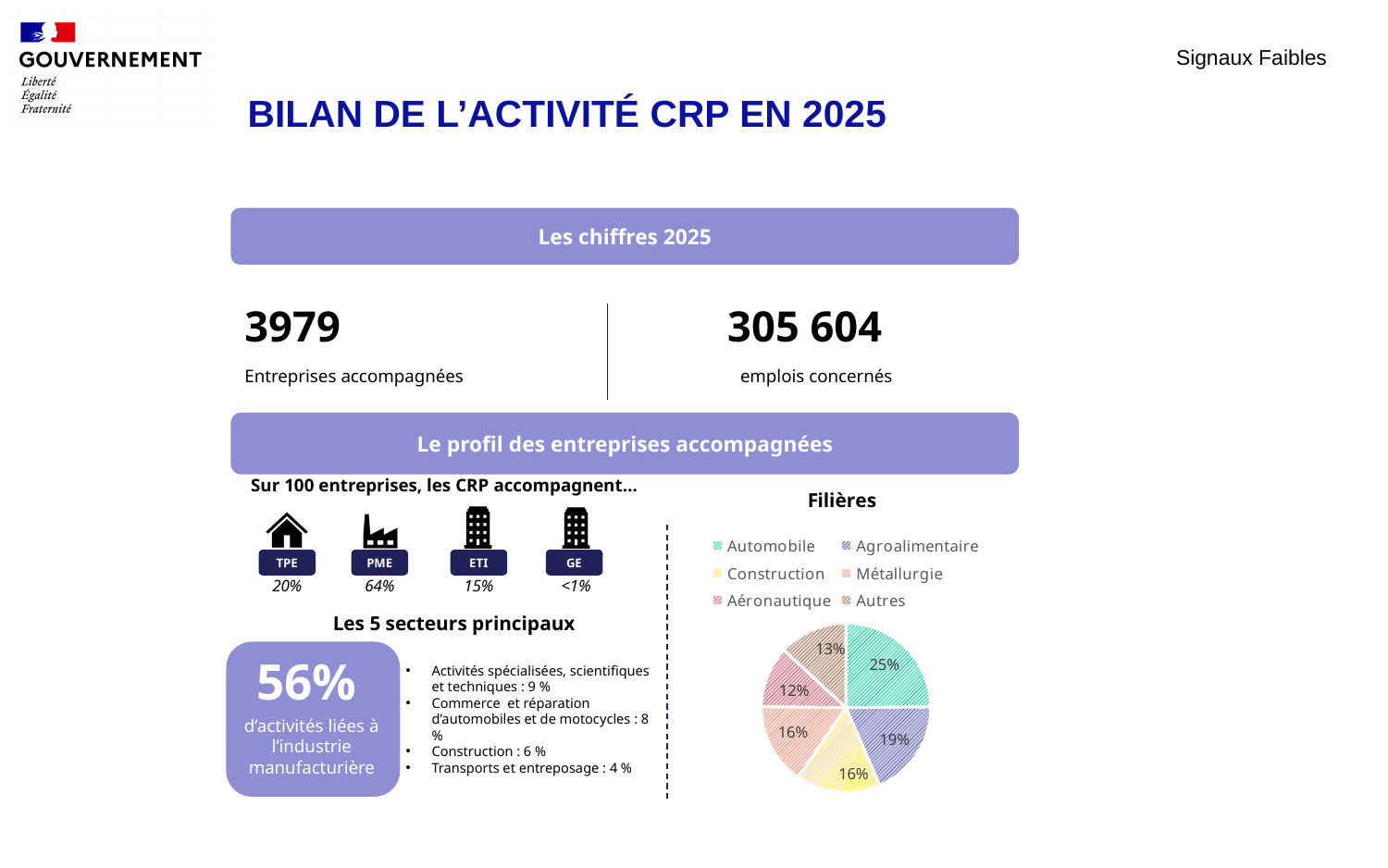
In the "Filières" pie chart, how many percentage points larger is Automobile than Agroalimentaire? 6 What type of chart is shown under the heading "Filières"? Pie chart Which sector has the largest slice in the "Filières" pie chart? Automobile In the "Filières" pie chart, what share does Construction have? 16% In the "Filières" pie chart, what share does Autres have? 13% In the "Filières" pie chart, what share does Aéronautique have? 12% Which sector has the smallest slice in the "Filières" pie chart? Aéronautique In the "Filières" pie chart, what share does Agroalimentaire have? 19% In the "Filières" pie chart, what share does Automobile have? 25% What is the title of the pie chart on the slide? Filières In the "Filières" pie chart, which is larger: Autres or Agroalimentaire? Agroalimentaire How many slices does the "Filières" pie chart have? 6